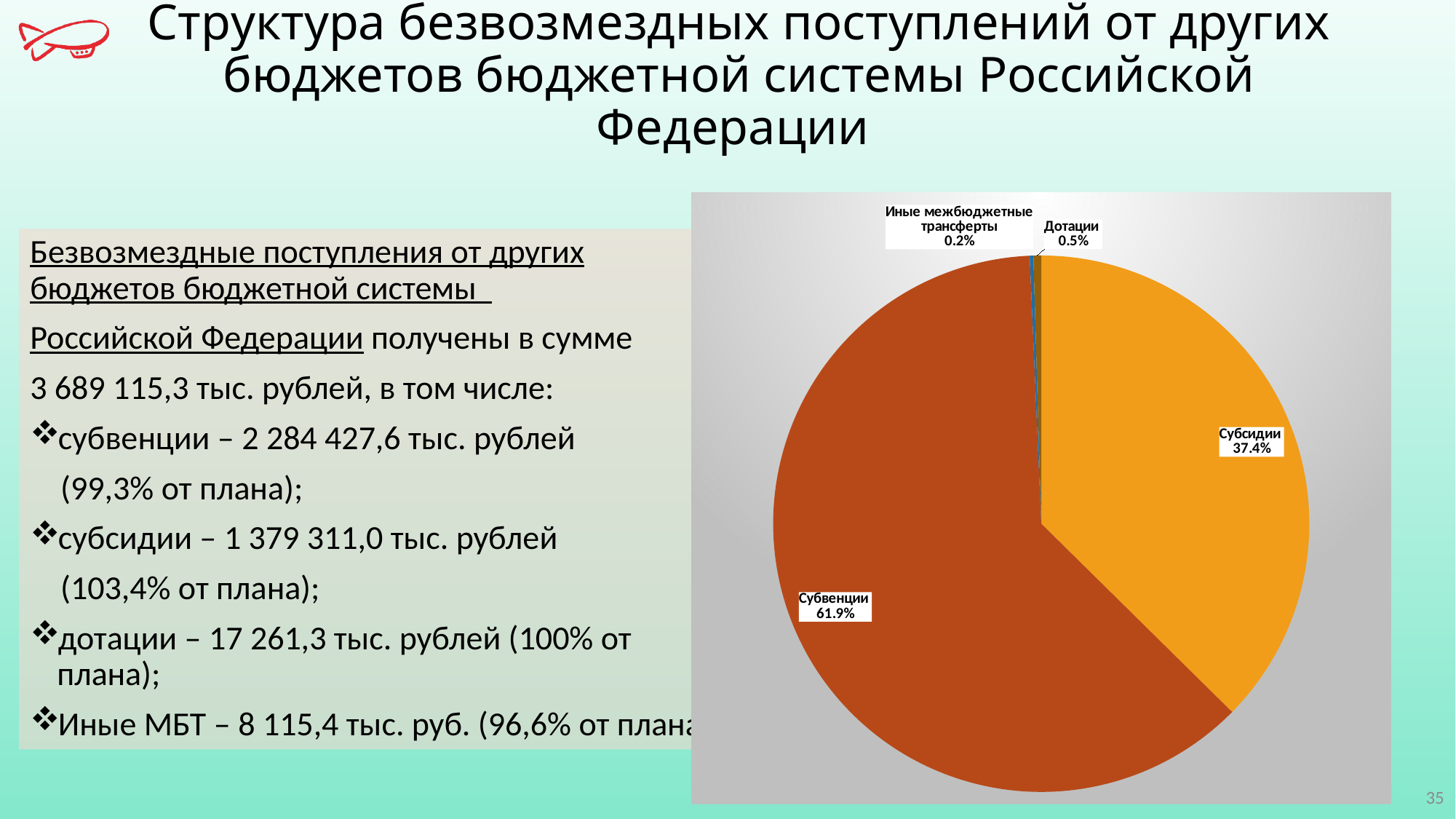
What share of the pie chart is labelled for Субсидии? 37.4% Which slice of the pie chart is the smallest? Иные межбюджетные трансферты Which slice of the pie chart is the largest? Субвенции What share of the pie chart is labelled for Субвенции? 61.9% What colour is the Субсидии slice in the pie chart? Orange By how many percentage points does the Субвенции slice exceed the Субсидии slice? 24.5% What percentage is shown for Иные межбюджетные трансферты in the pie chart? 0.2% Which is larger in the pie chart, Дотации or Иные межбюджетные трансферты? Дотации Is the share for Субсидии greater or less than 50%? less How many slices does the pie chart have? 4 What kind of chart is shown on the slide? Pie chart What percentage is shown for Дотации in the pie chart? 0.5%